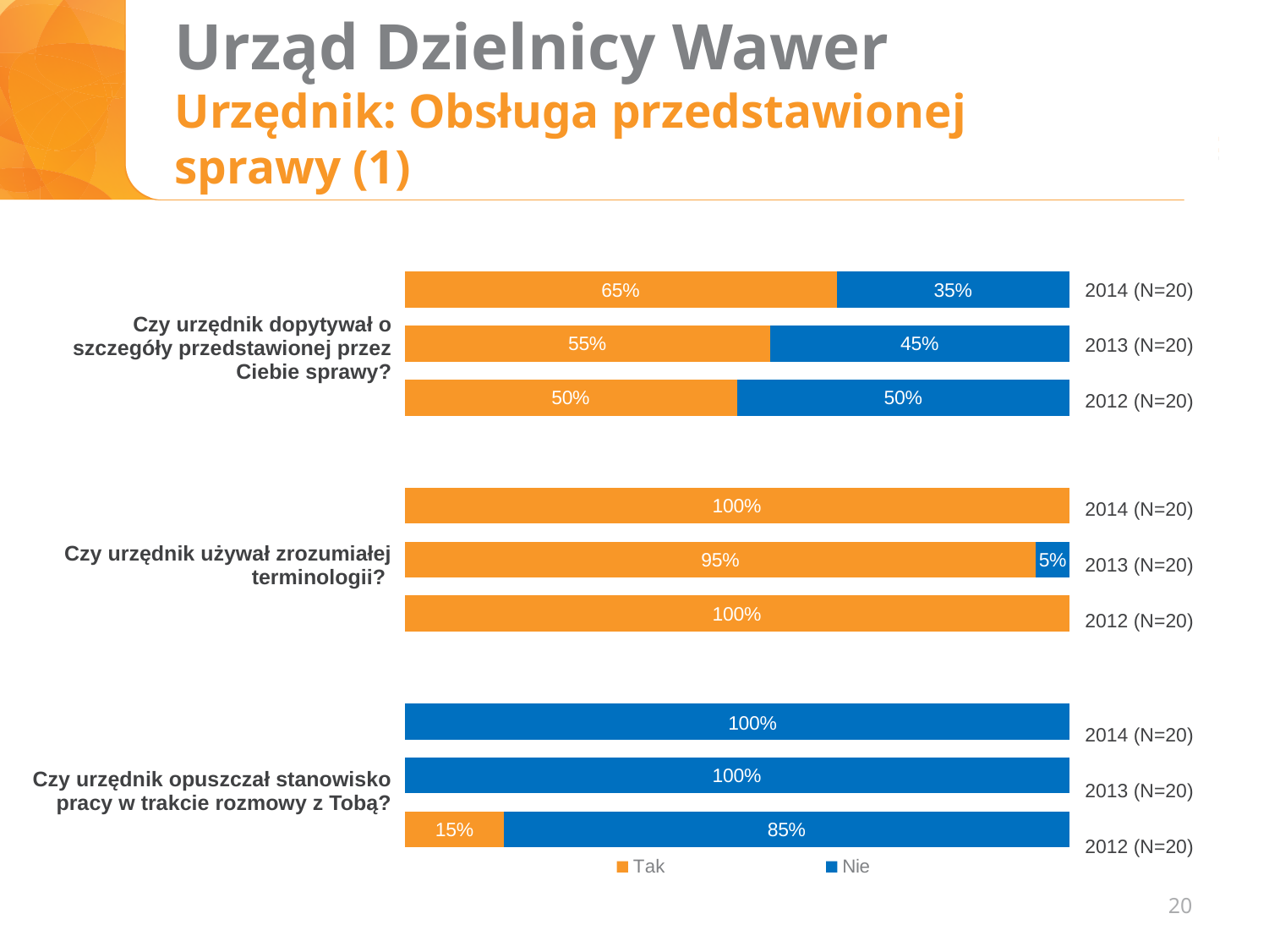
What are the two legend entries on the slide? Tak and Nie What kind of chart is used on this slide? Stacked bar chart In the chart for "Czy urzędnik dopytywał o szczegóły przedstawionej przez Ciebie sprawy?", what is the Tak value for 2014 (N=20)? 65% In the chart for "Czy urzędnik dopytywał o szczegóły przedstawionej przez Ciebie sprawy?", what is the Nie value for 2013 (N=20)? 45% In the chart for "Czy urzędnik dopytywał o szczegóły przedstawionej przez Ciebie sprawy?", which is larger for 2013: Tak or Nie? Tak How many series does the legend list on this slide? 2 In the chart for "Czy urzędnik dopytywał o szczegóły przedstawionej przez Ciebie sprawy?", does the Tak share rise or fall from 2012 to 2014? rise In the chart for "Czy urzędnik opuszczał stanowisko pracy w trakcie rozmowy z Tobą?", what is the Tak value for 2012 (N=20)? 15% In the chart for "Czy urzędnik używał zrozumiałej terminologii?", what is the Nie value for 2013 (N=20)? 5% How many years (bars) are shown for each question on the slide? 3 In the chart for "Czy urzędnik dopytywał o szczegóły przedstawionej przez Ciebie sprawy?", which year has the highest Tak value? 2014 In the chart for "Czy urzędnik dopytywał o szczegóły przedstawionej przez Ciebie sprawy?", by how many percentage points does the Tak value for 2014 exceed the Tak value for 2012? 15 percentage points